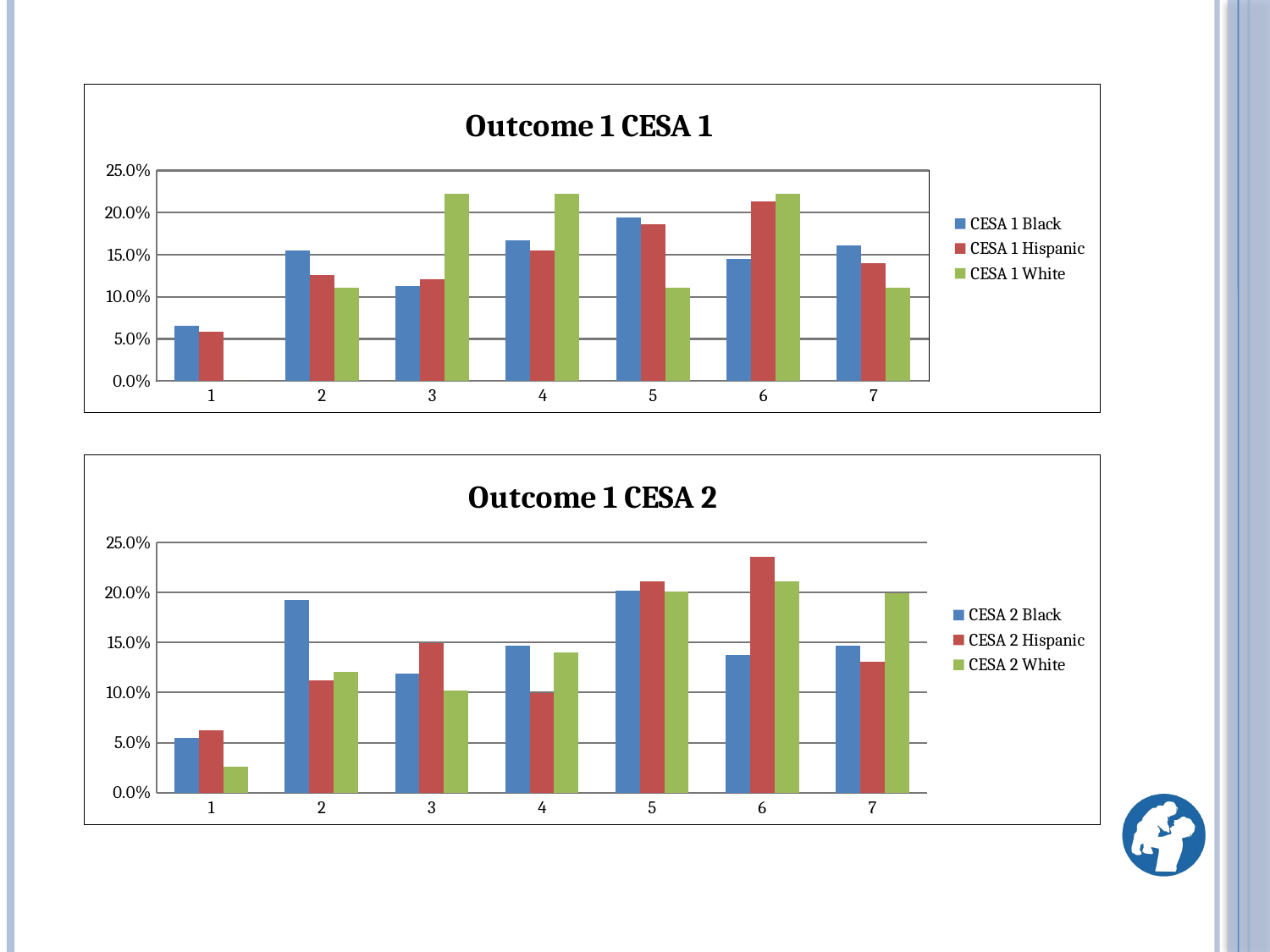
In the "Outcome 1 CESA 1" chart, is the value for CESA 1 White at category 3 greater or less than 20.0%? greater In the "Outcome 1 CESA 1" chart, which category has the highest CESA 1 Black value? 5 In the "Outcome 1 CESA 2" chart, which category has the lowest CESA 2 White value? 1 How many series does the legend of the "Outcome 1 CESA 1" chart list? 3 In the "Outcome 1 CESA 2" chart, is the value for CESA 2 Hispanic at category 6 greater or less than 20.0%? greater In the "Outcome 1 CESA 2" chart, which category has the highest CESA 2 Hispanic value? 6 In the "Outcome 1 CESA 1" chart, at category 5, which is larger: CESA 1 Black or CESA 1 White? CESA 1 Black What are the legend entries of the "Outcome 1 CESA 2" chart? CESA 2 Black, CESA 2 Hispanic, CESA 2 White How many categories are shown on the x axis of the "Outcome 1 CESA 2" chart? 7 In the "Outcome 1 CESA 1" chart, is the value for CESA 1 Black at category 1 greater or less than 10.0%? less What kind of chart is the "Outcome 1 CESA 1" chart? Bar chart In the "Outcome 1 CESA 2" chart, at category 2, which is larger: CESA 2 Black or CESA 2 Hispanic? CESA 2 Black